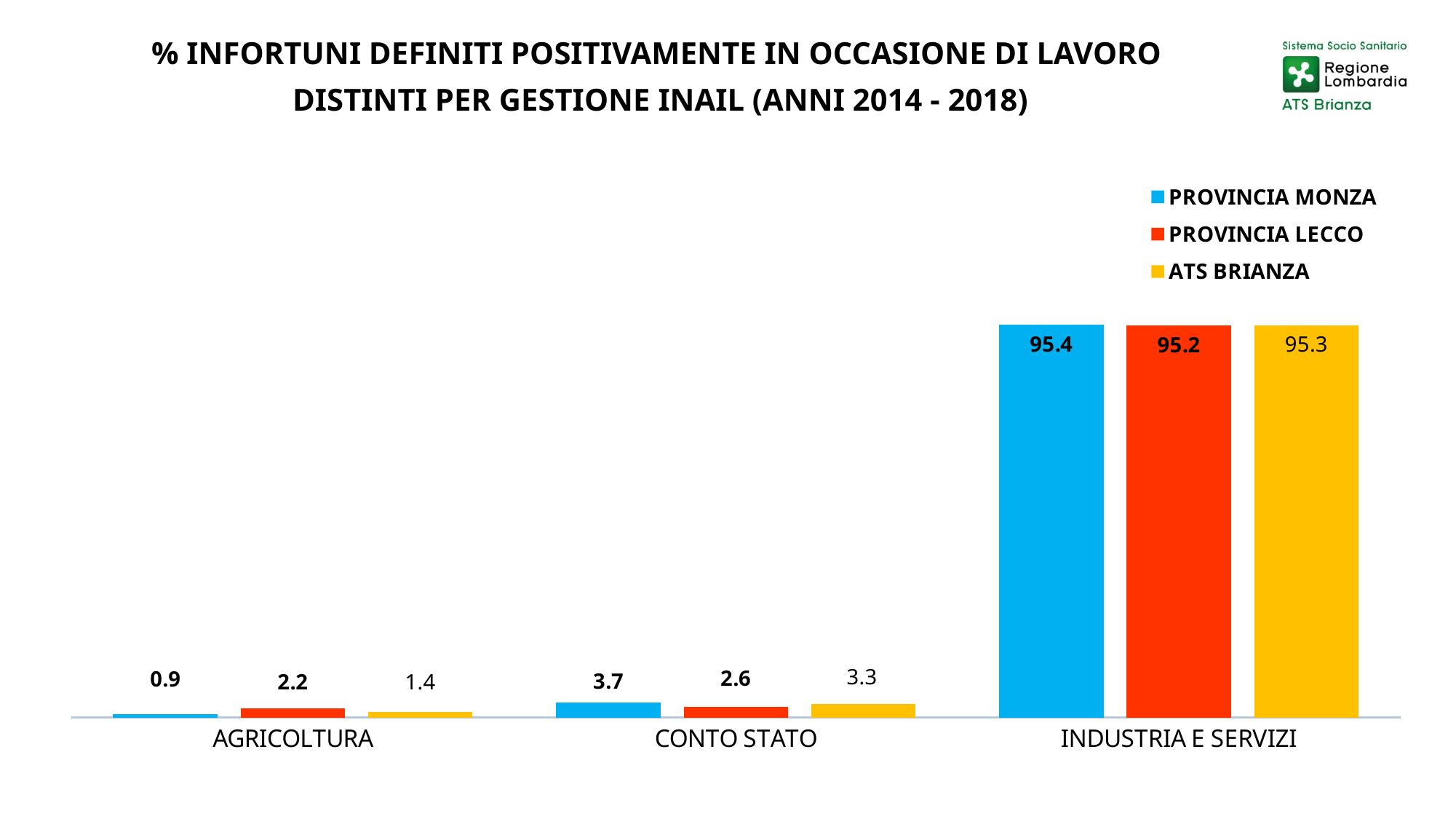
What is the value for ATS BRIANZA in the CONTO STATO category? 3.3 What kind of chart is shown on the slide? Bar chart What is the difference between the PROVINCIA MONZA and PROVINCIA LECCO values in the CONTO STATO category? 1.1 How many series does the legend list? 3 Which category has the lowest value for ATS BRIANZA? AGRICOLTURA In the AGRICOLTURA category, which is larger: the value for PROVINCIA LECCO or for ATS BRIANZA? PROVINCIA LECCO How many categories are shown on the x axis? 3 What is the difference between the PROVINCIA LECCO and PROVINCIA MONZA values in the AGRICOLTURA category? 1.3 Which category has the highest value for PROVINCIA MONZA? INDUSTRIA E SERVIZI What is the value for PROVINCIA LECCO in the INDUSTRIA E SERVIZI category? 95.2 Which colour represents ATS BRIANZA in the chart? Yellow What is the value for PROVINCIA MONZA in the AGRICOLTURA category? 0.9